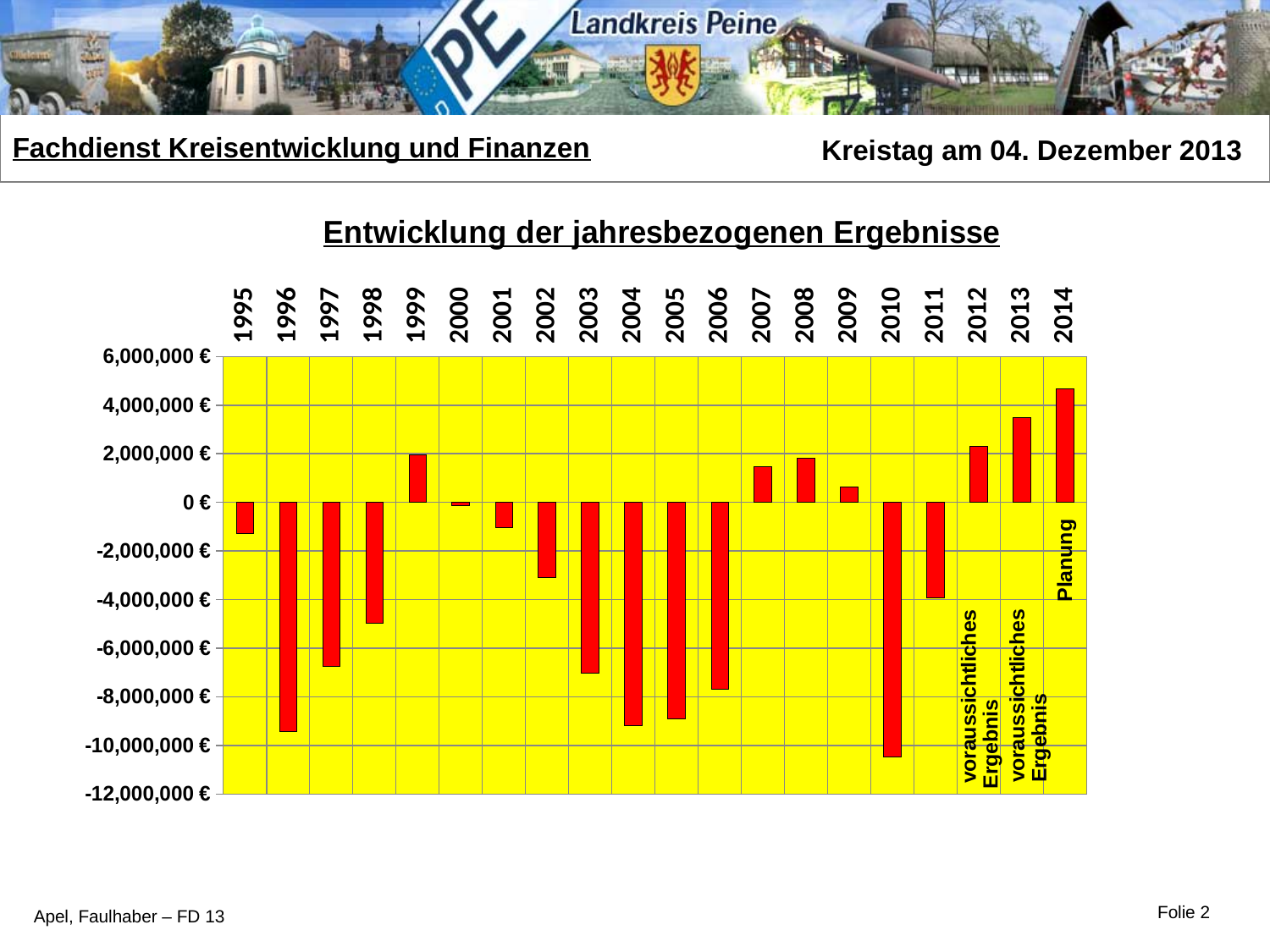
Which year has the highest value in the chart? 2014 Is the value for 2010 greater or less than -10,000,000 €? less Which year has the lowest value in the chart? 2010 Which label is written next to the bar for 2014? Planung Is the value for 2013 greater or less than 2,000,000 €? greater Which year has the larger value, 2013 or 2014? 2014 How many years are plotted on the x axis of the chart? 20 What kind of chart is shown on the slide? bar chart Is the value for 1996 greater or less than -8,000,000 €? less What is the title of the chart? Entwicklung der jahresbezogenen Ergebnisse Do the values rise or fall from 2011 to 2014? rise